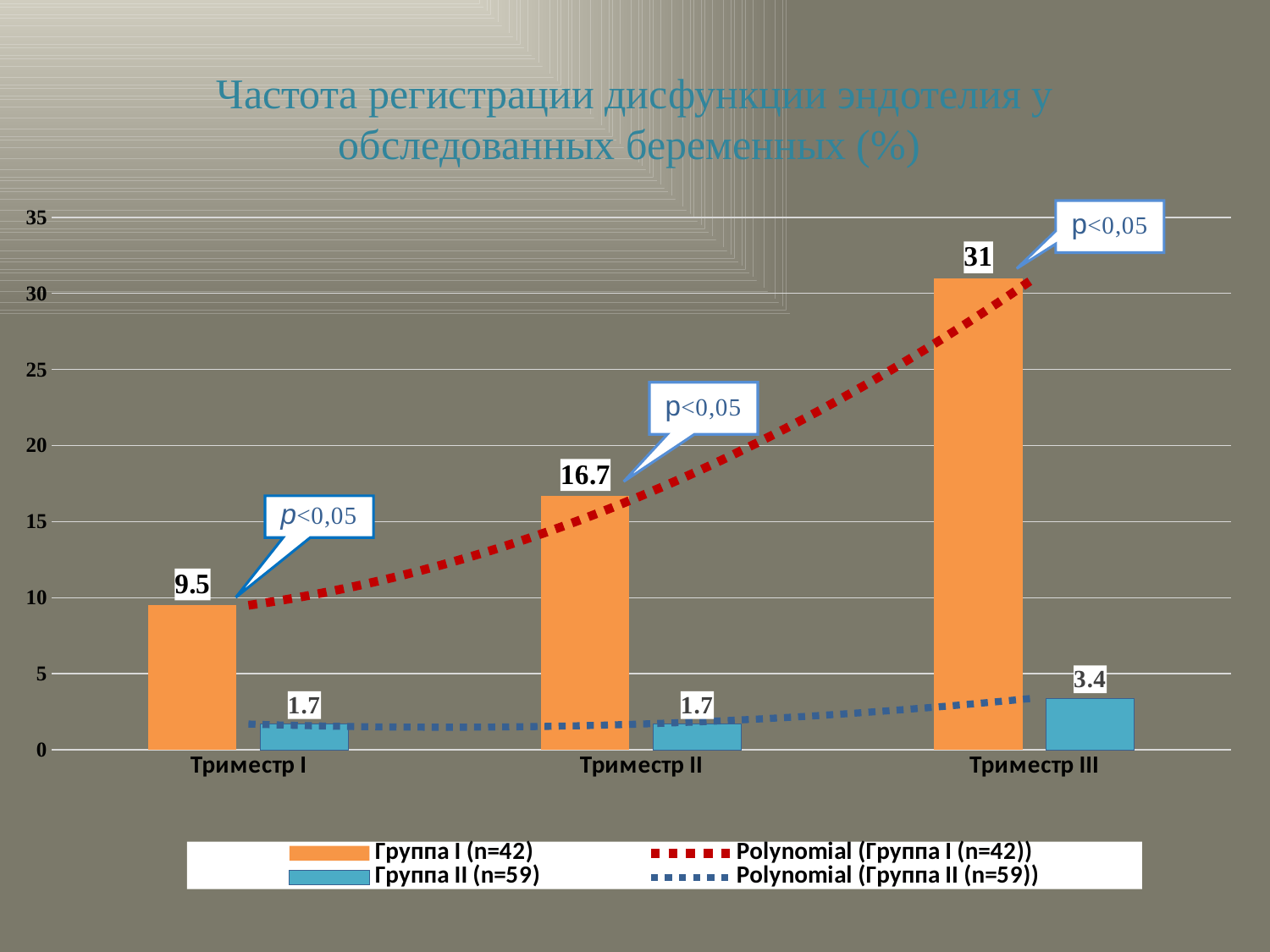
What kind of chart is this? Bar chart What is the difference between Группа I (n=42) and Группа II (n=59) in Триместр III? 27.6 How many entries does the legend list? 4 In which trimester is the value for Группа I (n=42) highest? Триместр III What is the value for Группа I (n=42) in Триместр II? 16.7 What is the value for Группа I (n=42) in Триместр III? 31 In which trimester is the value for Группа I (n=42) lowest? Триместр I What is the value for Группа II (n=59) in Триместр I? 1.7 Which is larger in Триместр II: Группа I (n=42) or Группа II (n=59)? Группа I (n=42) How many trimester categories are shown on the x axis? 3 What is the difference between the Группа I (n=42) values in Триместр II and Триместр I? 7.2 Do the values for Группа I (n=42) rise or fall from Триместр I to Триместр III? Rise